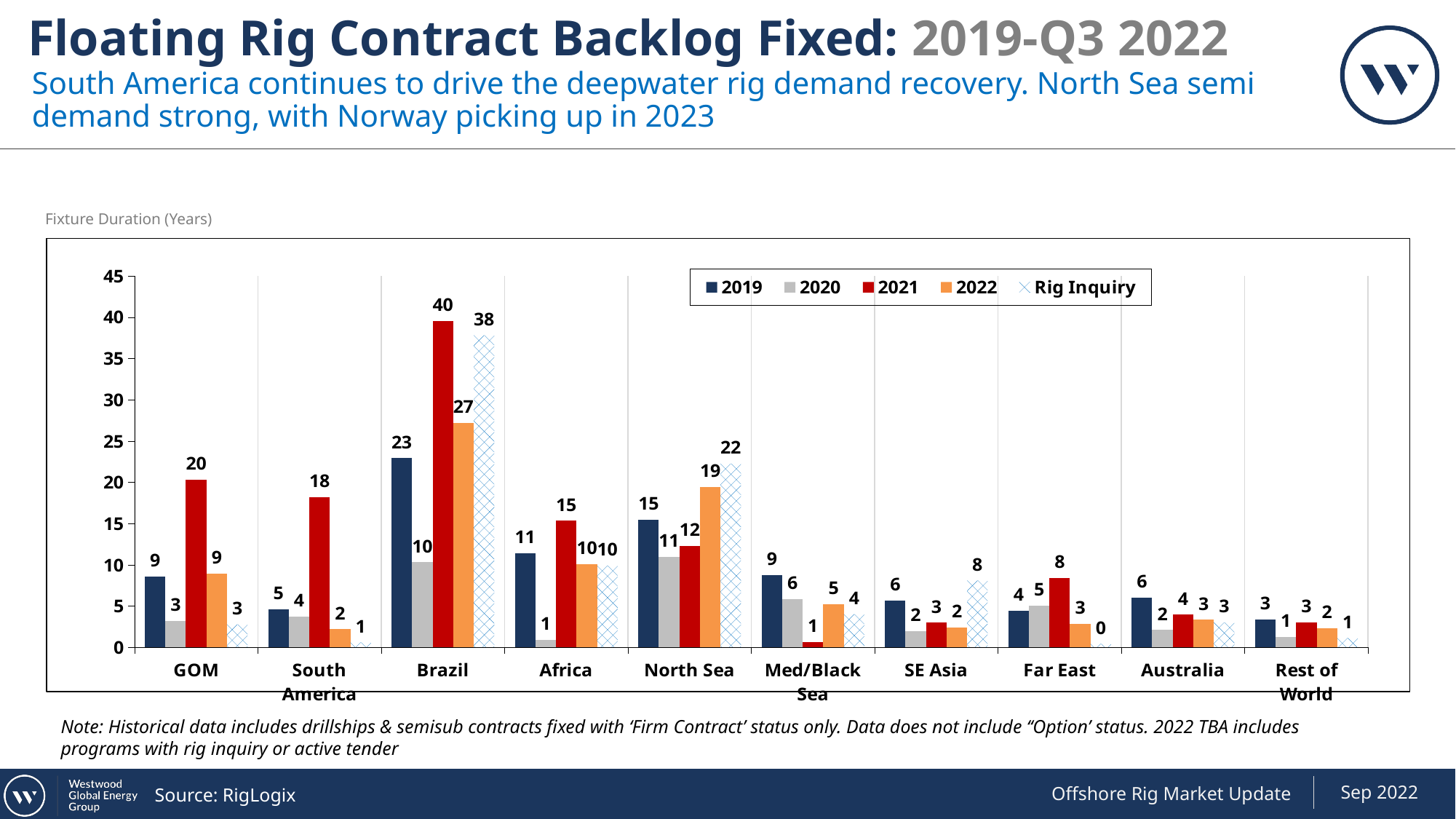
How many regions are shown on the x axis? 10 What is the label on the y axis of the chart? Fixture Duration (Years) What is the 2022 value for Med/Black Sea? 5 How many series does the legend list? 5 Which region has the highest 2019 value? Brazil What is the Rig Inquiry value for North Sea? 22 Which region has the lowest Rig Inquiry value? Far East What is the difference between the 2021 and 2022 values for Brazil? 13 What kind of chart is shown on the slide? Bar chart What is the 2021 value for Brazil? 40 What is the difference between the 2021 values for GOM and South America? 2 Which is larger for North Sea: the 2019 value or the 2022 value? 2022